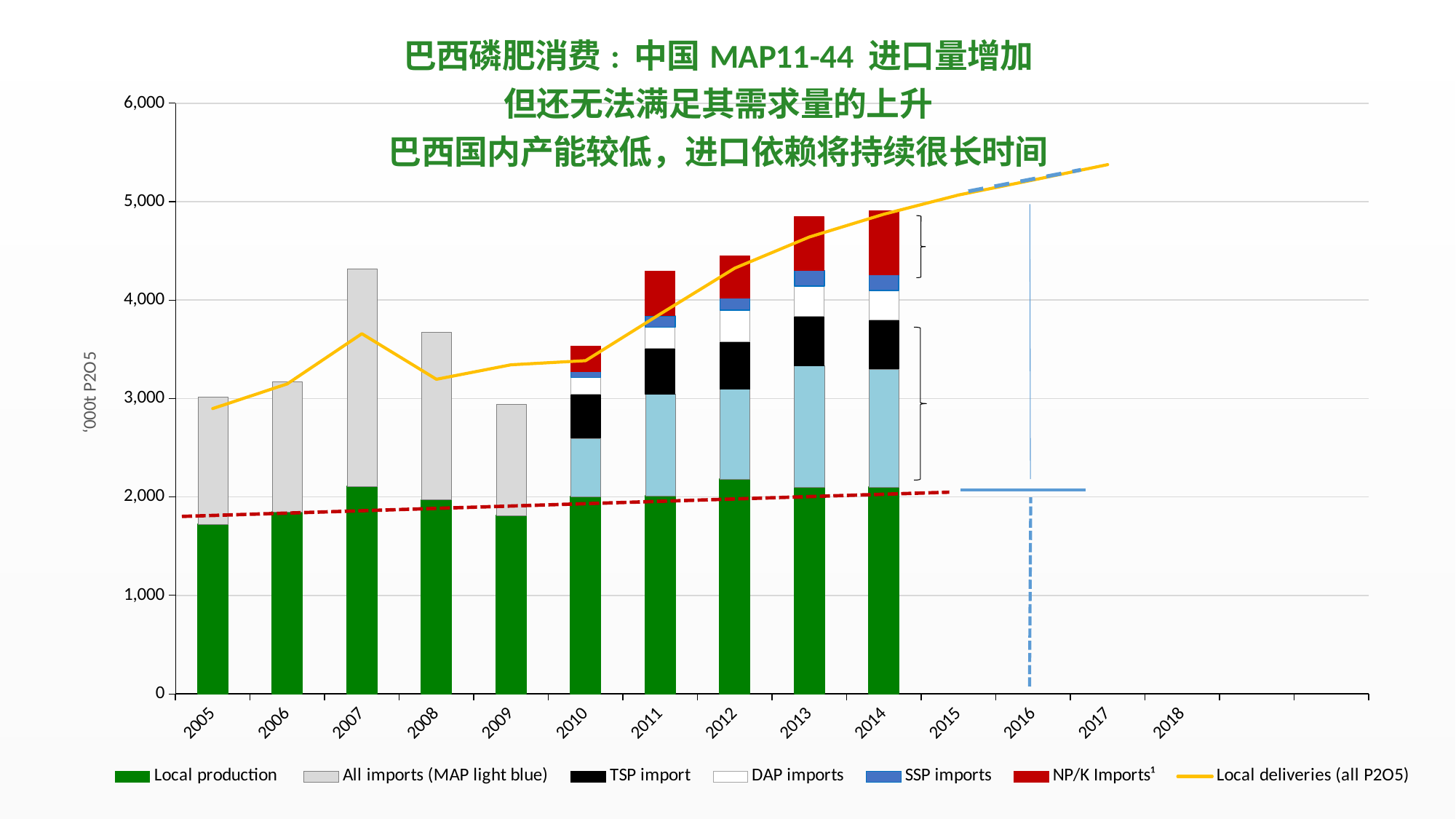
Is the Local deliveries (all P2O5) value for 2007 greater or less than 3,000? greater How many year labels are shown on the x axis? 14 Does the Local deliveries (all P2O5) line generally rise or fall from 2005 to 2014? rise Which year has the higher Local deliveries (all P2O5) value, 2007 or 2008? 2007 Is the Local deliveries (all P2O5) value for 2014 greater or less than 4,000? greater Is the Local production value for 2005 greater or less than 2,000? less What kind of chart is shown on the slide? Stacked bar chart with a line How many years have stacked bars plotted on the chart? 10 How many series does the legend list? 7 What is the label on the y axis? '000t P2O5 Which year has the taller stacked bar, 2007 or 2008? 2007